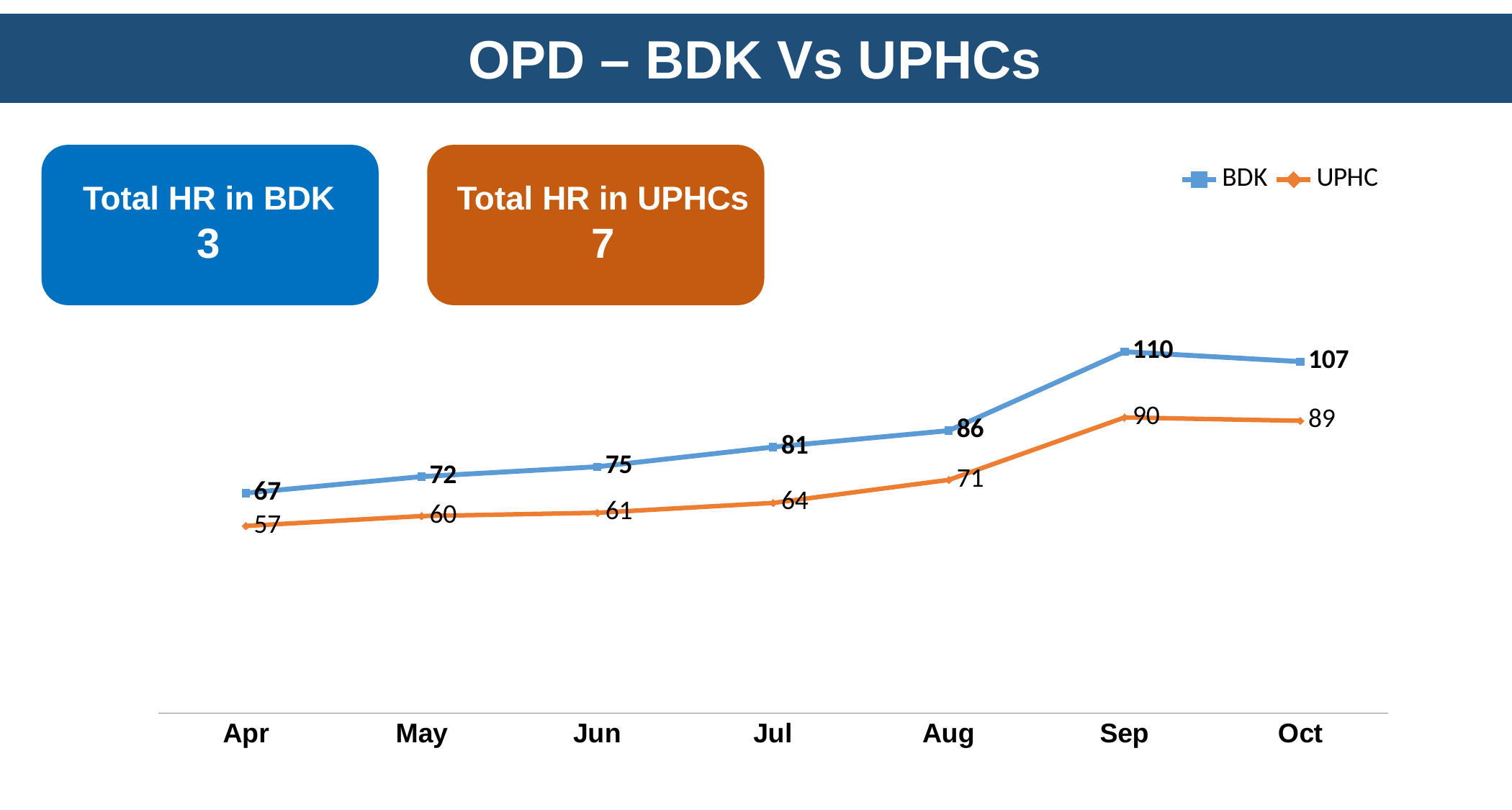
What is the UPHC value for Oct? 89 How many months are shown on the x axis? 7 Which is larger in Aug, the BDK value or the UPHC value? BDK What is the UPHC value for Apr? 57 Does the UPHC series rise or fall from Apr to Sep? Rise What is the BDK value for Sep? 110 What is the difference between the BDK values for Sep and Aug? 24 What kind of chart is shown on the slide? Line chart In which month is the UPHC series lowest? Apr What is the difference between the BDK and UPHC values in Jul? 17 In which month is the BDK series highest? Sep How many series does the legend list? 2